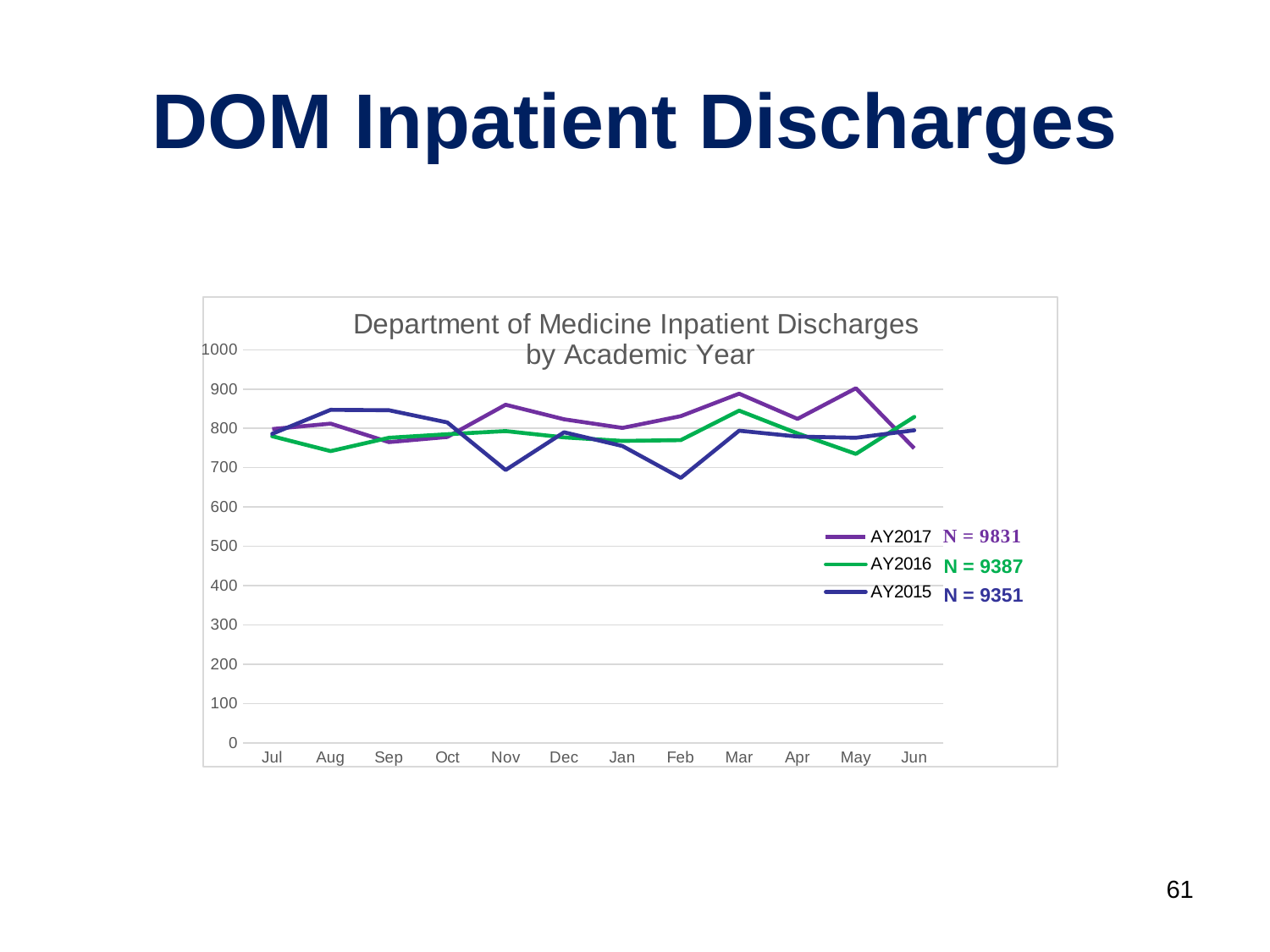
What kind of chart is shown on the slide? line chart Is the value for AY2017 in Mar greater or less than 800? greater What is the difference between the N values for AY2017 and AY2016? 444 In Nov, which series has the higher value, AY2017 or AY2015? AY2017 How many months are plotted along the x axis? 12 Is the value for AY2015 in Feb greater or less than 700? less Is the value for AY2016 in Aug greater or less than 800? less How many series does the legend list? 3 Which academic year has the largest N value? AY2017 What is the title of the chart? Department of Medicine Inpatient Discharges by Academic Year What is the N value shown for AY2017? N = 9831 What is the N value shown for AY2015? N = 9351